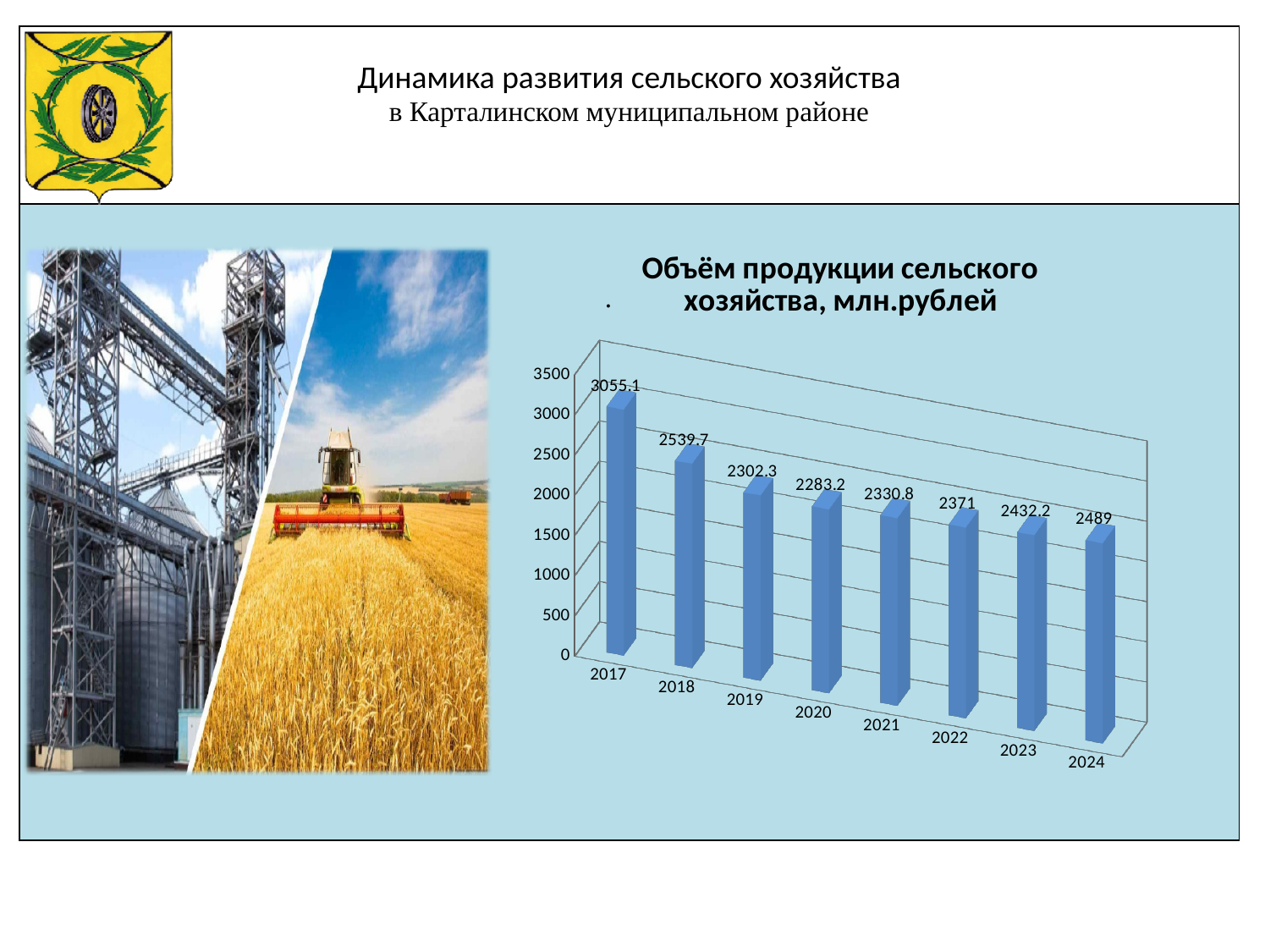
Is the value for 2018 greater or less than 2500? greater Which year has the lowest value in the chart? 2020 Which year has the highest value in the chart? 2017 How many years are shown in the chart? 8 What kind of chart is shown on the slide? bar chart What is the difference between the values for 2017 and 2018? 515.4 What is the value for 2020 in the chart? 2283.2 Do the values rise or fall from 2020 to 2024? rise What is the difference between the values for 2024 and 2023? 56.8 What is the value for 2017 in the chart? 3055.1 What is the value for 2024 in the chart? 2489 Which is larger, the value for 2019 or the value for 2022? 2022